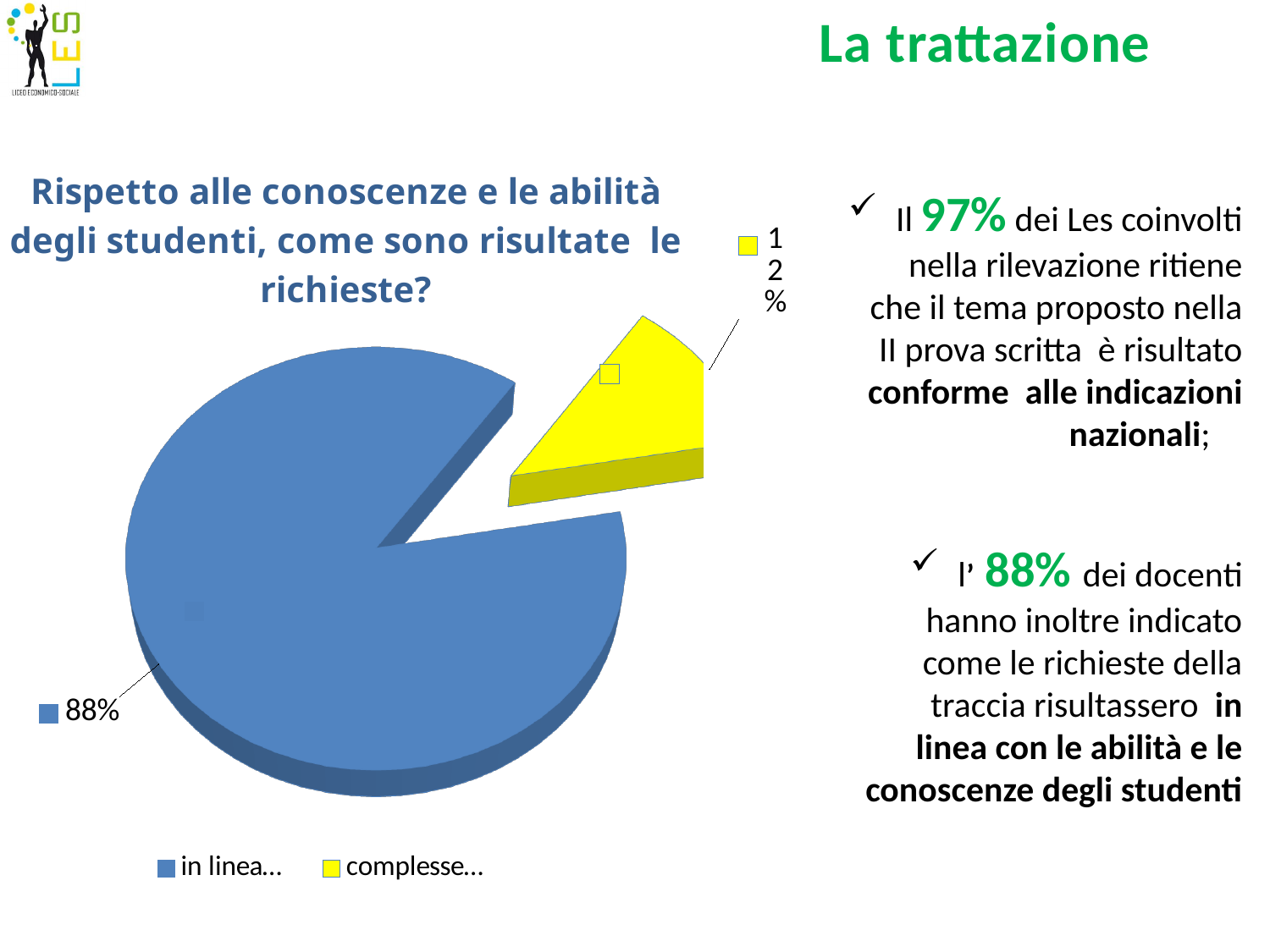
Which slice of the pie chart is the smallest? complesse… What is the difference in percentage points between the "in linea…" slice and the "complesse…" slice? 76 Which slice of the pie chart is the largest? in linea… What percentage is shown for the "in linea…" slice of the pie chart? 88% What is the title of the pie chart? Rispetto alle conoscenze e le abilità degli studenti, come sono risultate le richieste? How many entries does the legend of the pie chart list? 2 What kind of chart is shown on the slide? pie chart What share of the pie does the "complesse…" slice represent? 12% Which is larger in the pie chart: "in linea…" or "complesse…"? in linea… What colour is the "complesse…" slice in the pie chart? yellow How many slices does the pie chart have? 2 What percentage is shown for the "complesse…" slice of the pie chart? 12%